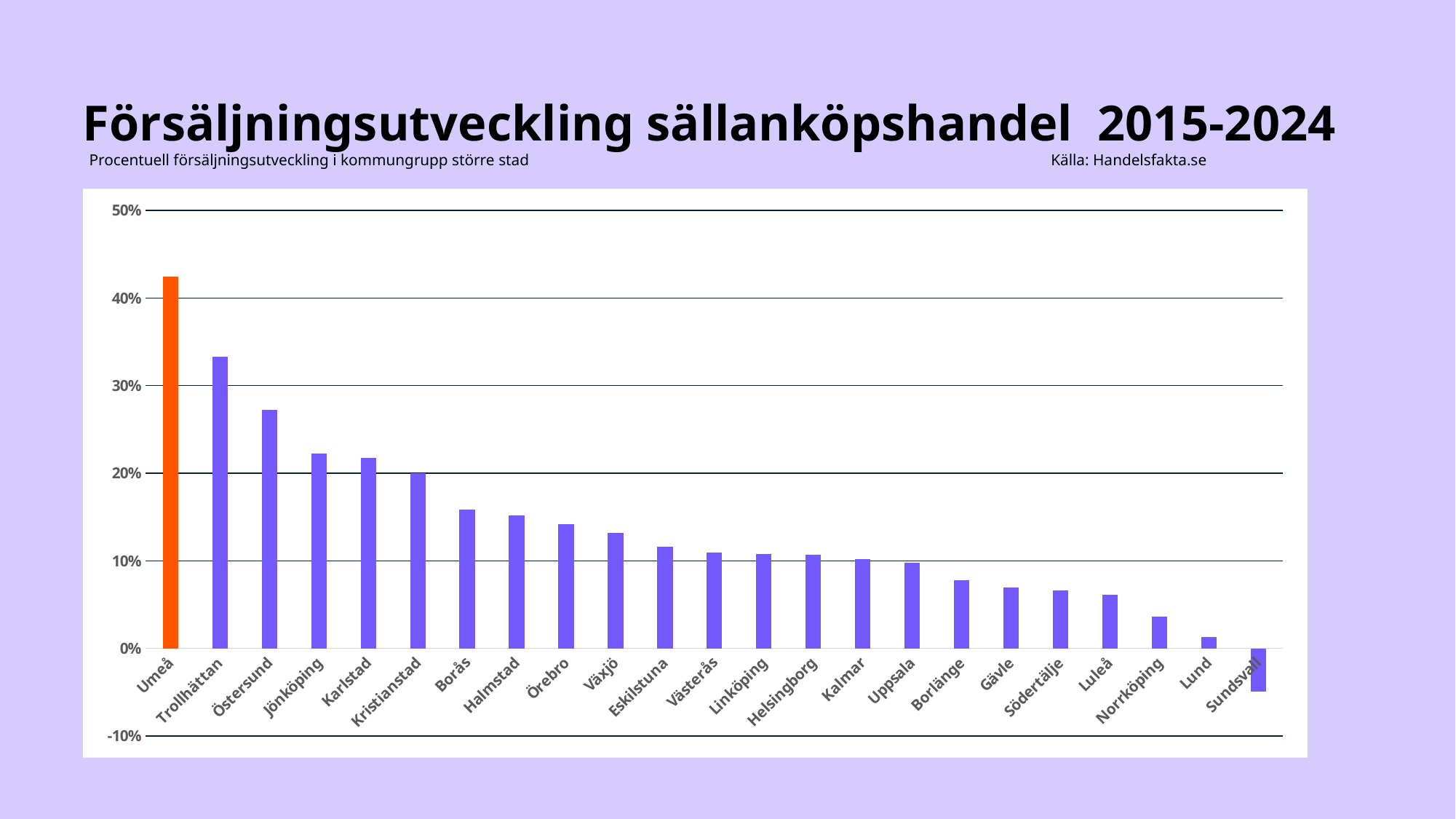
Is the value for Östersund greater or less than 30%? less How many municipalities are shown on the x axis of the chart? 23 Which municipality has the highest sales growth in the chart? Umeå Which municipality has the lowest sales growth in the chart? Sundsvall Is the value for Sundsvall greater or less than 0%? less Do the values generally rise or fall from left to right along the x axis? fall Is the value for Umeå greater or less than 40%? greater Which municipality's bar is coloured orange instead of purple? Umeå Which has the larger value, Jönköping or Halmstad? Jönköping What kind of chart is shown on the slide? bar chart